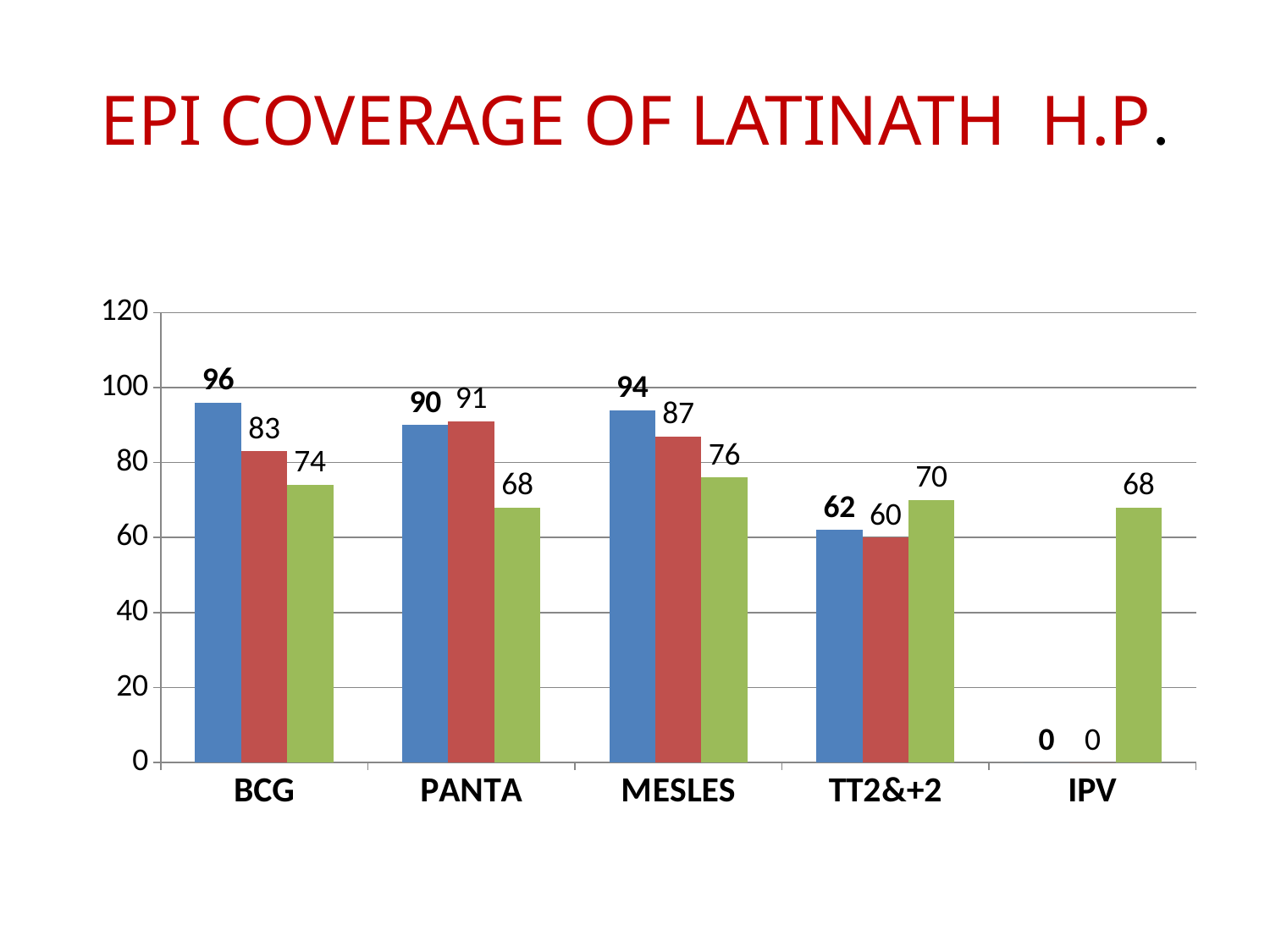
What is the value of the blue bar for BCG? 96 What is the value of the green bar for MESLES? 76 What is the difference between the blue and green bars for BCG? 22 Which category has the lowest green bar? PANTA and IPV (both 68) What is the value of the red bar for PANTA? 91 Is the value of the red bar for MESLES greater or less than 80? greater Which category has the highest blue bar? BCG How many categories are shown on the x axis? 5 What is the title of the slide? EPI COVERAGE OF LATINATH H.P. What is the value of the green bar for IPV? 68 What kind of chart is shown on the slide? bar chart Which is larger for TT2&+2, the blue bar or the green bar? the green bar